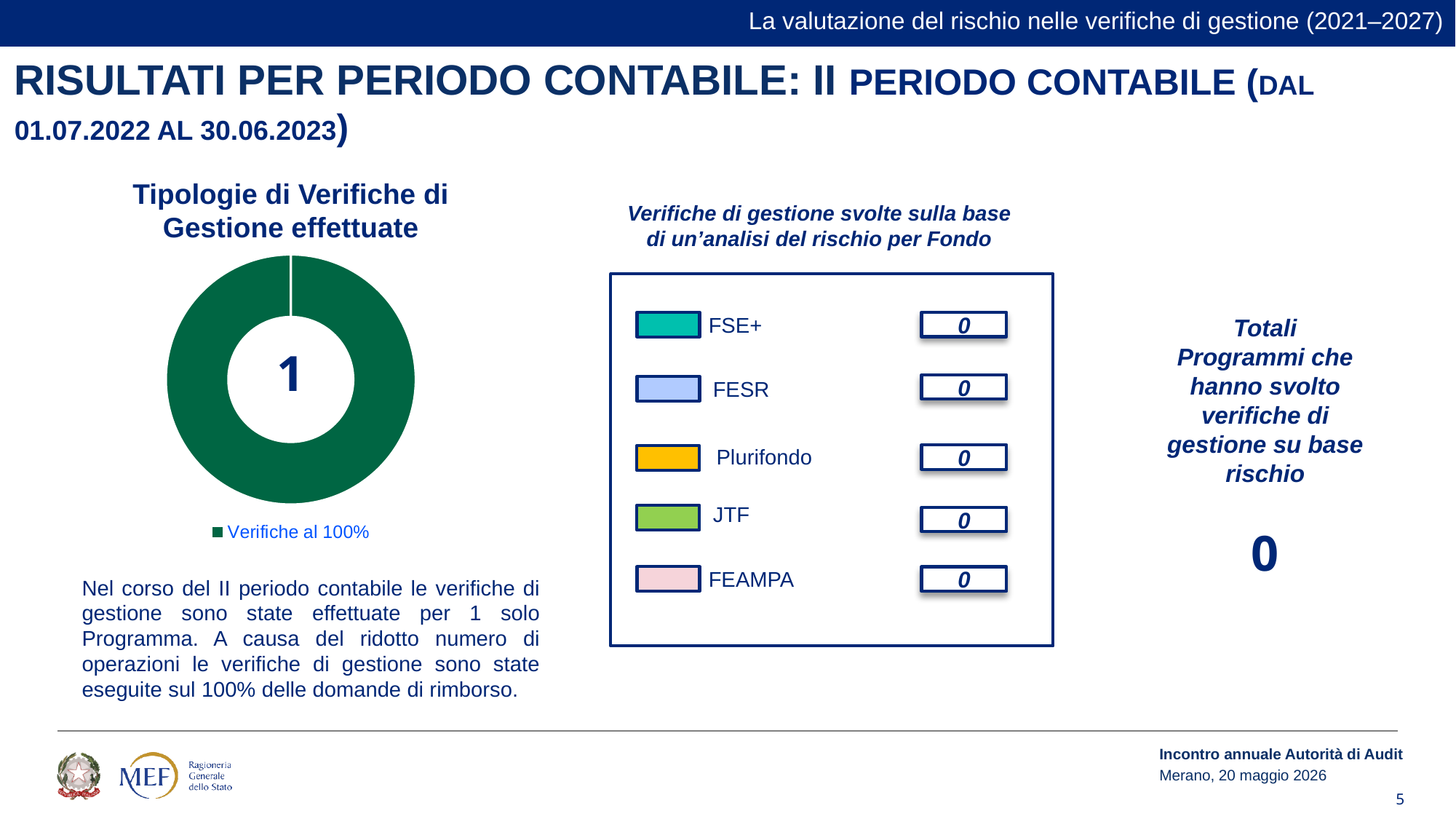
What is the total shown for 'Totali Programmi che hanno svolto verifiche di gestione su base rischio'? 0 In the panel 'Verifiche di gestione svolte sulla base di un'analisi del rischio per Fondo', what is the value for Plurifondo? 0 What is the legend entry of the chart 'Tipologie di Verifiche di Gestione effettuate'? Verifiche al 100% What kind of chart is 'Tipologie di Verifiche di Gestione effettuate'? doughnut (pie) chart What share of the doughnut chart 'Tipologie di Verifiche di Gestione effettuate' does the slice 'Verifiche al 100%' take up? 100% How many funds are listed in the panel 'Verifiche di gestione svolte sulla base di un'analisi del rischio per Fondo'? 5 In the panel 'Verifiche di gestione svolte sulla base di un'analisi del rischio per Fondo', what is the value for FSE+? 0 In the chart 'Tipologie di Verifiche di Gestione effettuate', what number is shown in the centre of the doughnut? 1 How many entries does the legend of the chart 'Tipologie di Verifiche di Gestione effettuate' list? 1 How many slices does the doughnut chart 'Tipologie di Verifiche di Gestione effettuate' have? 1 What colour is the slice in the chart 'Tipologie di Verifiche di Gestione effettuate'? green